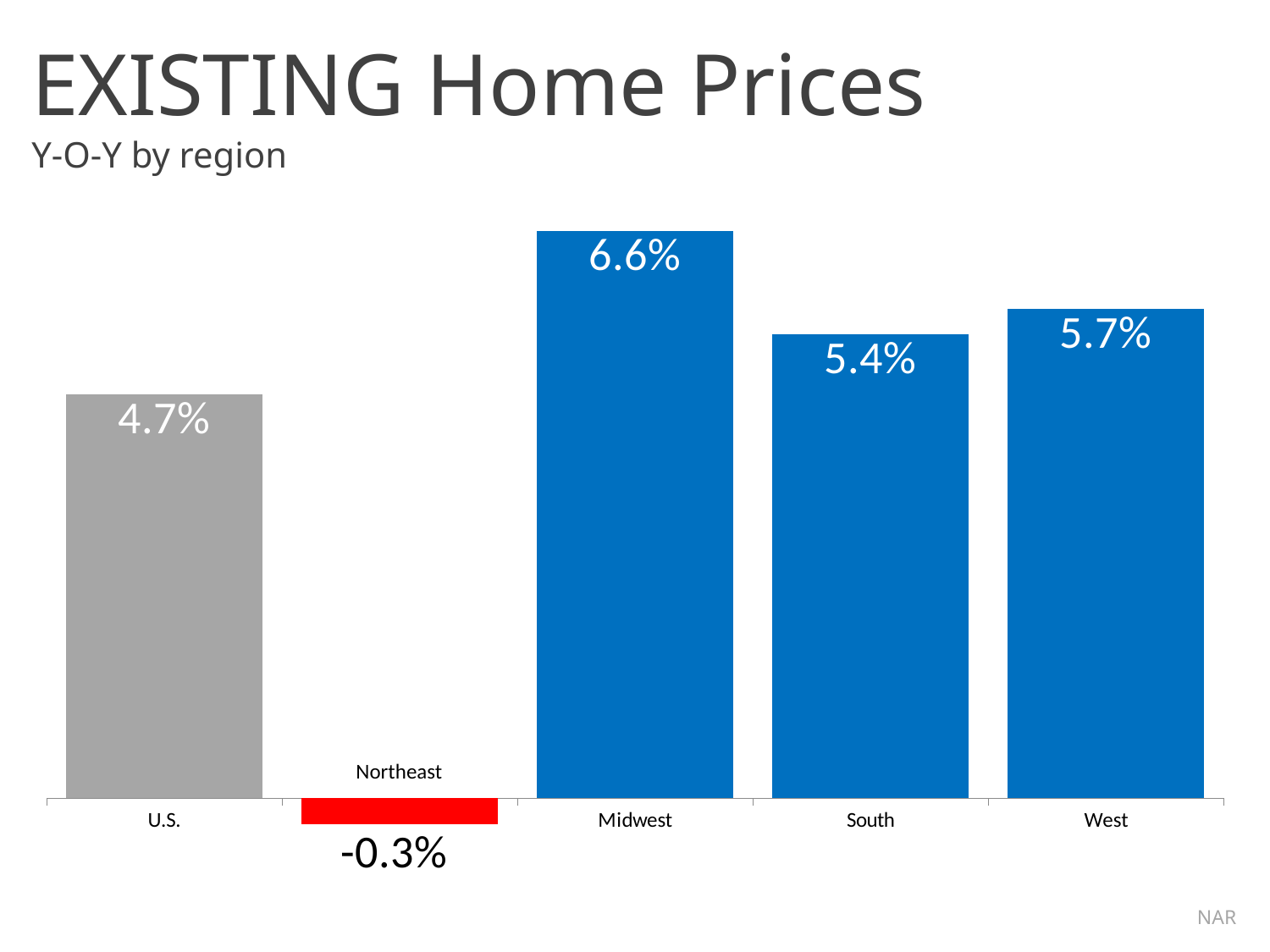
What colour is the bar for the Northeast? Red Which region has the highest Y-O-Y existing home price change? Midwest Which has a larger Y-O-Y price change, the South or the West? West What is the Y-O-Y existing home price change for the Northeast? -0.3% What is the difference between the West and U.S. Y-O-Y price changes? 1.0% What is the Y-O-Y existing home price change for the Midwest? 6.6% What is the Y-O-Y existing home price change for the U.S.? 4.7% How many categories are shown in the chart? 5 Which region has the lowest Y-O-Y existing home price change? Northeast What is the Y-O-Y existing home price change for the West? 5.7% What kind of chart is shown on the slide? Bar chart What is the difference between the Midwest and South Y-O-Y price changes? 1.2%